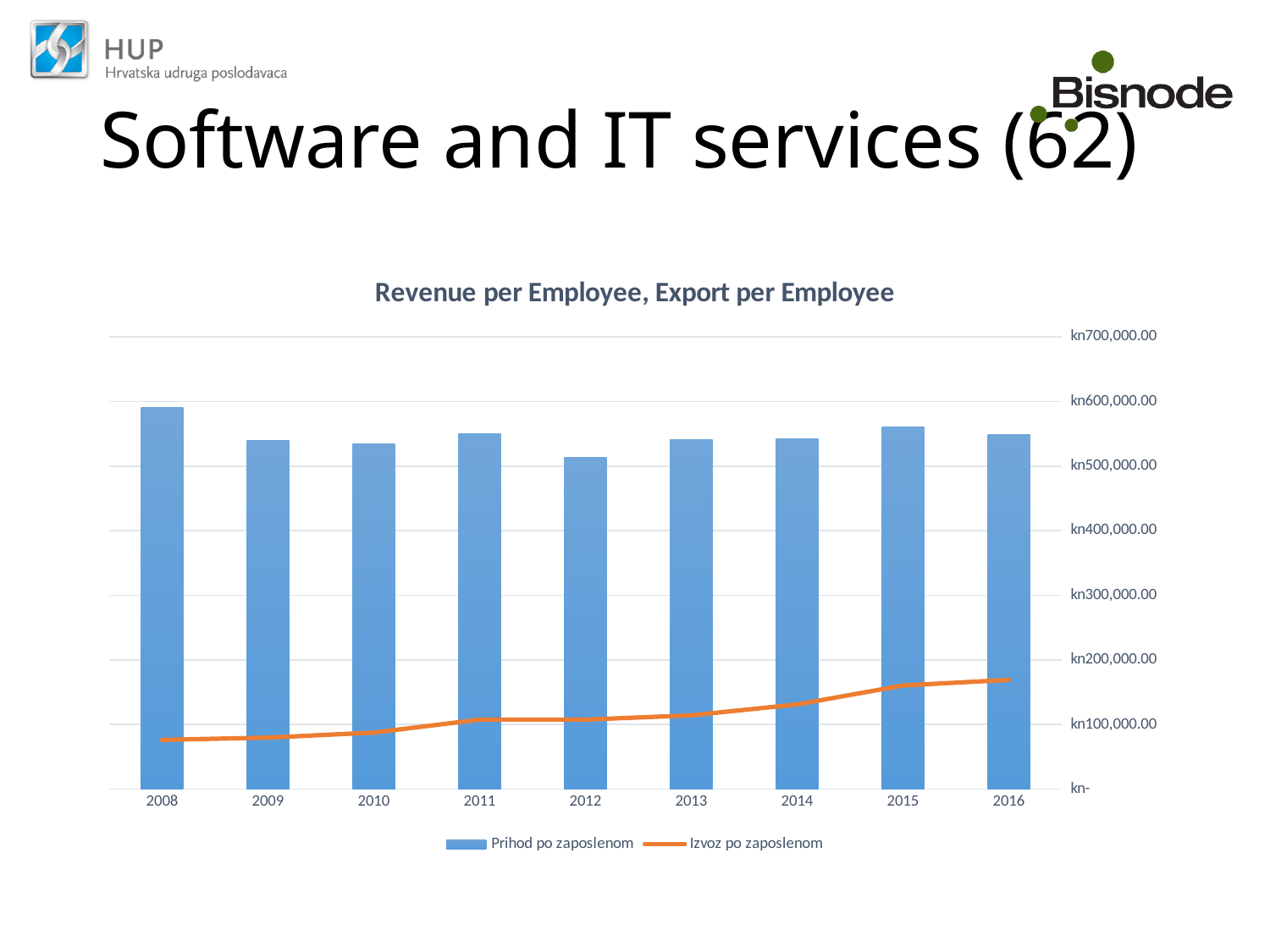
Is the Izvoz po zaposlenom value for 2016 greater or less than kn100,000.00? greater How many years are shown on the x axis? 9 Does the Izvoz po zaposlenom line rise or fall from 2008 to 2016? rise How many series does the legend list? 2 Is the Prihod po zaposlenom value for 2012 greater or less than kn600,000.00? less Is the Prihod po zaposlenom value for 2008 greater or less than kn500,000.00? greater Which series is drawn as a line? Izvoz po zaposlenom In which year is the Prihod po zaposlenom bar the highest? 2008 In which year is the Prihod po zaposlenom bar the lowest? 2012 Which year has the larger Prihod po zaposlenom value, 2008 or 2012? 2008 What is the title of the chart? Revenue per Employee, Export per Employee What kind of chart is shown on the slide? A combined bar and line chart